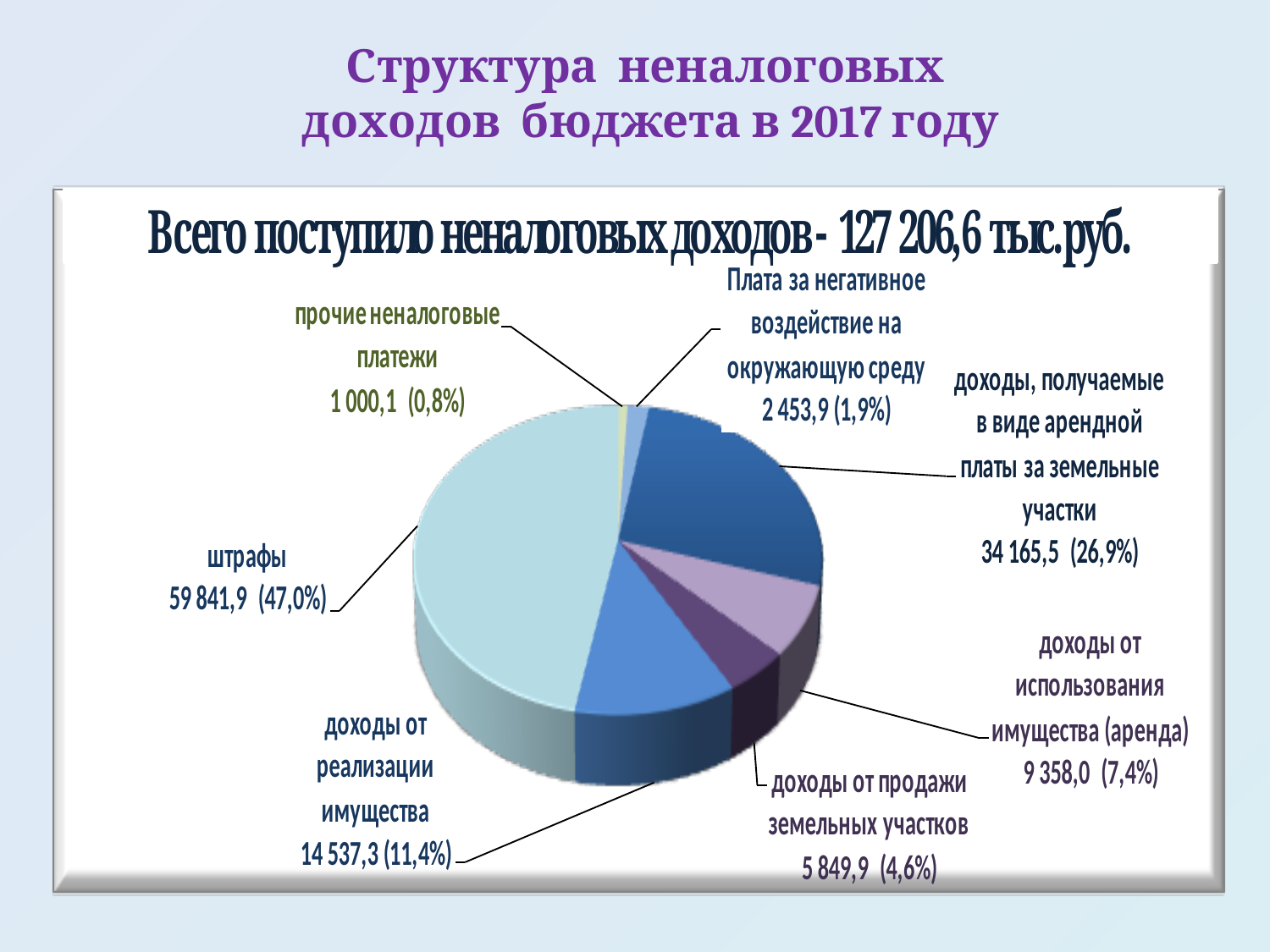
What is the difference in percentage share between штрафы and доходы, получаемые в виде арендной платы за земельные участки? 20,1% Which is larger: доходы от использования имущества (аренда) or Плата за негативное воздействие на окружающую среду? доходы от использования имущества (аренда) What value is shown for доходы, получаемые в виде арендной платы за земельные участки? 34 165,5 What share of the pie does штрафы account for? 47,0% Which category has the smallest slice of the pie? прочие неналоговые платежи What kind of chart is shown on the slide? pie chart What share of the pie is доходы от реализации имущества? 11,4% What total amount of non-tax revenue is stated in the chart title? 127 206,6 тыс.руб. What value is shown for доходы от продажи земельных участков? 5 849,9 How many slices does the pie chart have? 7 What value is shown for штрафы? 59 841,9 Which category has the largest slice of the pie? штрафы